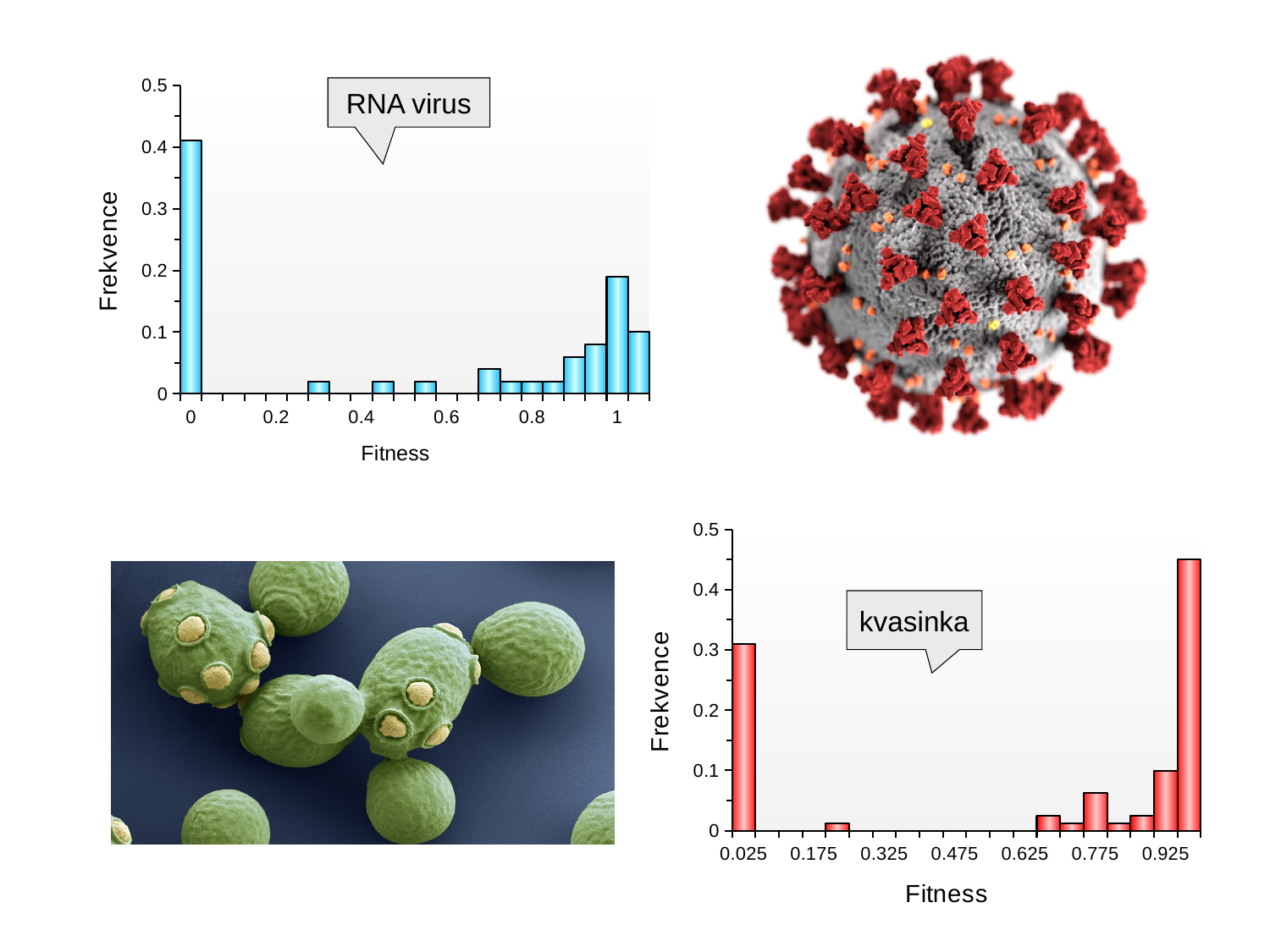
What kind of chart is the kvasinka chart? bar chart In the RNA virus chart, at which fitness value is the tallest bar? 0 In the RNA virus chart, which bar is taller: the one at fitness 0 or the one at fitness 1? fitness 0 In the kvasinka chart, which bar is taller: the one at fitness 0.025 or the rightmost bar? the rightmost bar In the RNA virus chart, is the value of the bar at fitness 0.3 greater or less than 0.1? less What is the label of the y axis on both charts? Frekvence What kind of chart is the RNA virus chart? bar chart In the kvasinka chart, is the value of the tallest bar at the right end greater or less than 0.4? greater In the kvasinka chart, is the value of the bar at fitness 0.775 greater or less than 0.1? less